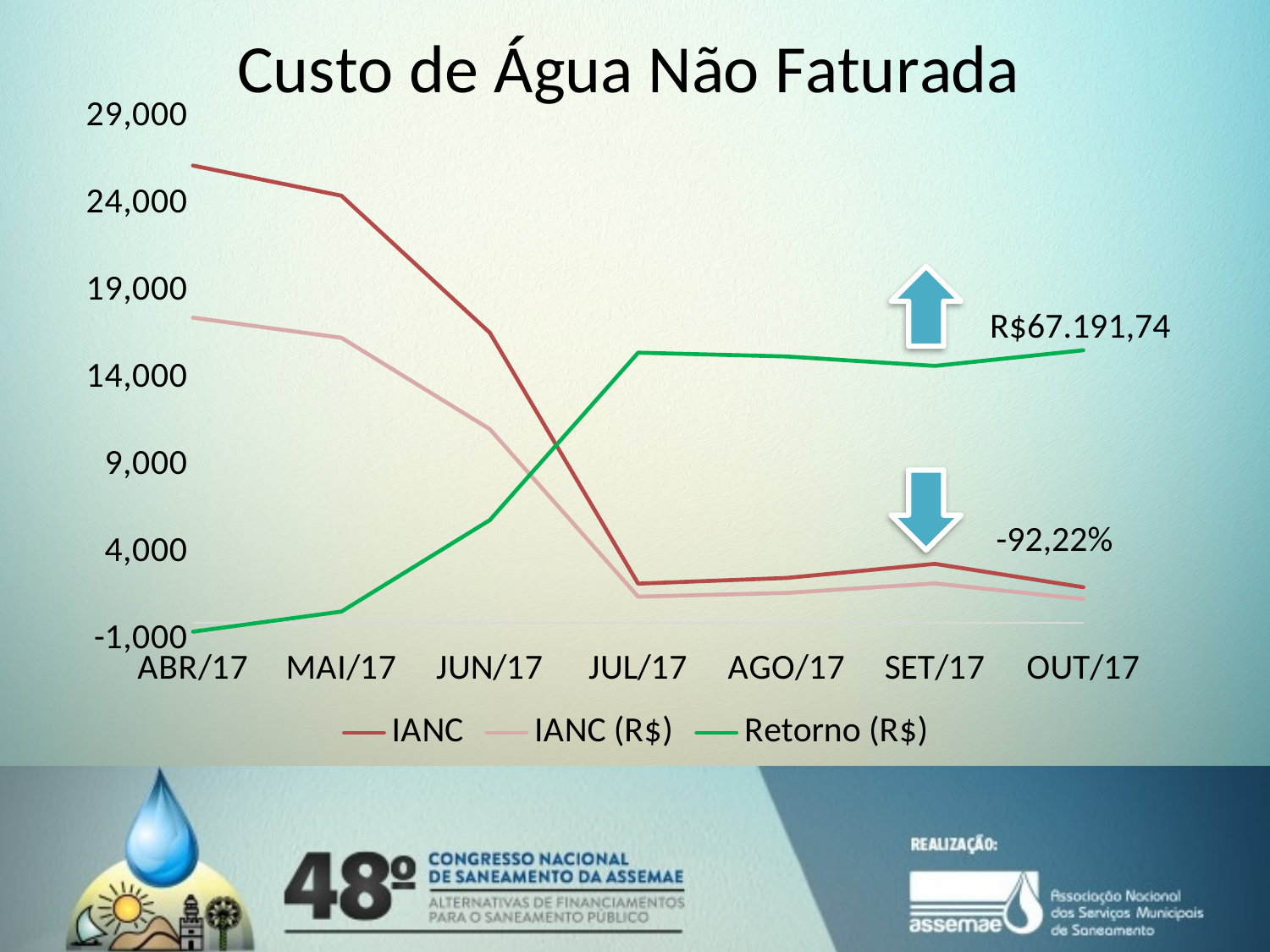
Is the Retorno (R$) value for JUL/17 greater or less than 14,000? greater What is the title of the chart? Custo de Água Não Faturada Is the IANC value for ABR/17 greater or less than 24,000? greater How many series does the legend list? 3 What kind of chart is shown on the slide? line chart Which series is drawn in green? Retorno (R$) Does the IANC series rise or fall from ABR/17 to JUL/17? fall In which month is the Retorno (R$) series at its lowest? ABR/17 How many months are shown on the x axis? 7 At JUL/17, which is larger: IANC or Retorno (R$)? Retorno (R$) Is the IANC value for JUL/17 greater or less than 4,000? less In which month is the IANC series at its highest? ABR/17